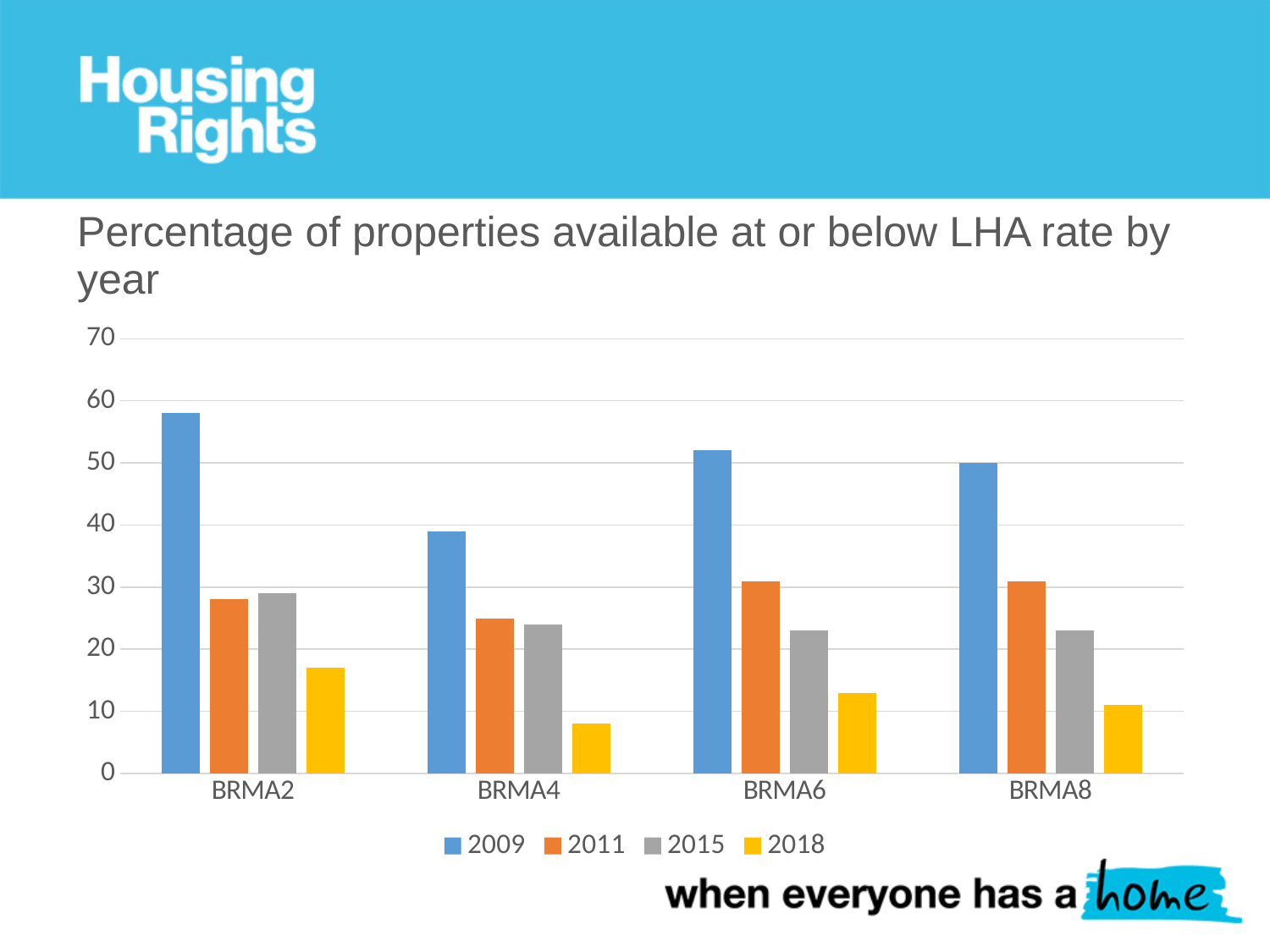
Is the 2018 value for BRMA4 greater or less than 10? less How many BRMA categories are shown on the x axis? 4 Is the 2009 value for BRMA2 greater or less than 50? greater Is the 2009 value for BRMA6 greater or less than 40? greater Which colour represents the 2018 series in the legend? yellow Within BRMA2, which year has the lowest value? 2018 How many series does the legend list? 4 Which BRMA has the lowest value for 2018? BRMA4 What kind of chart is shown on the slide? bar chart Which BRMA has the highest value for 2009? BRMA2 Which is larger, the 2009 value for BRMA2 or the 2009 value for BRMA4? BRMA2 For BRMA8, do the values rise or fall from 2009 to 2018? fall